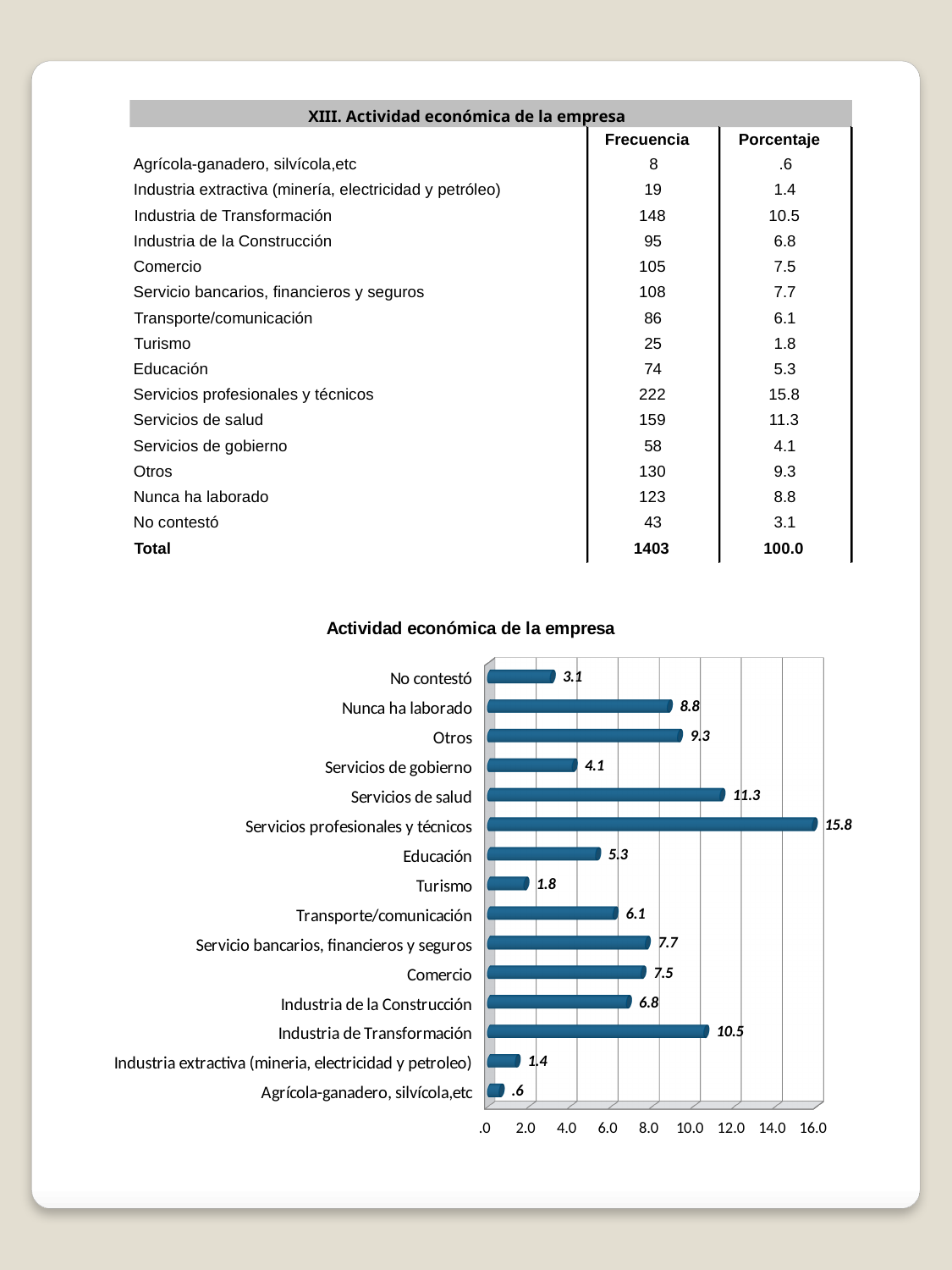
What is the difference between the values for Comercio and Educación? 2.2 How many categories are shown in the chart? 15 What is the value for Turismo in the chart? 1.8 Is the value for Industria de Transformación greater or less than 10.0? greater What is the value for Industria de Transformación in the chart? 10.5 What kind of chart is shown on the slide? Bar chart What is the title of the chart? Actividad económica de la empresa Which category has the highest value in the chart? Servicios profesionales y técnicos What is the difference between the values for Servicios profesionales y técnicos and Servicios de salud? 4.5 Which is larger, the value for Otros or the value for Nunca ha laborado? Otros What is the value for Servicios de salud in the chart? 11.3 Which category has the lowest value in the chart? Agrícola-ganadero, silvícola,etc